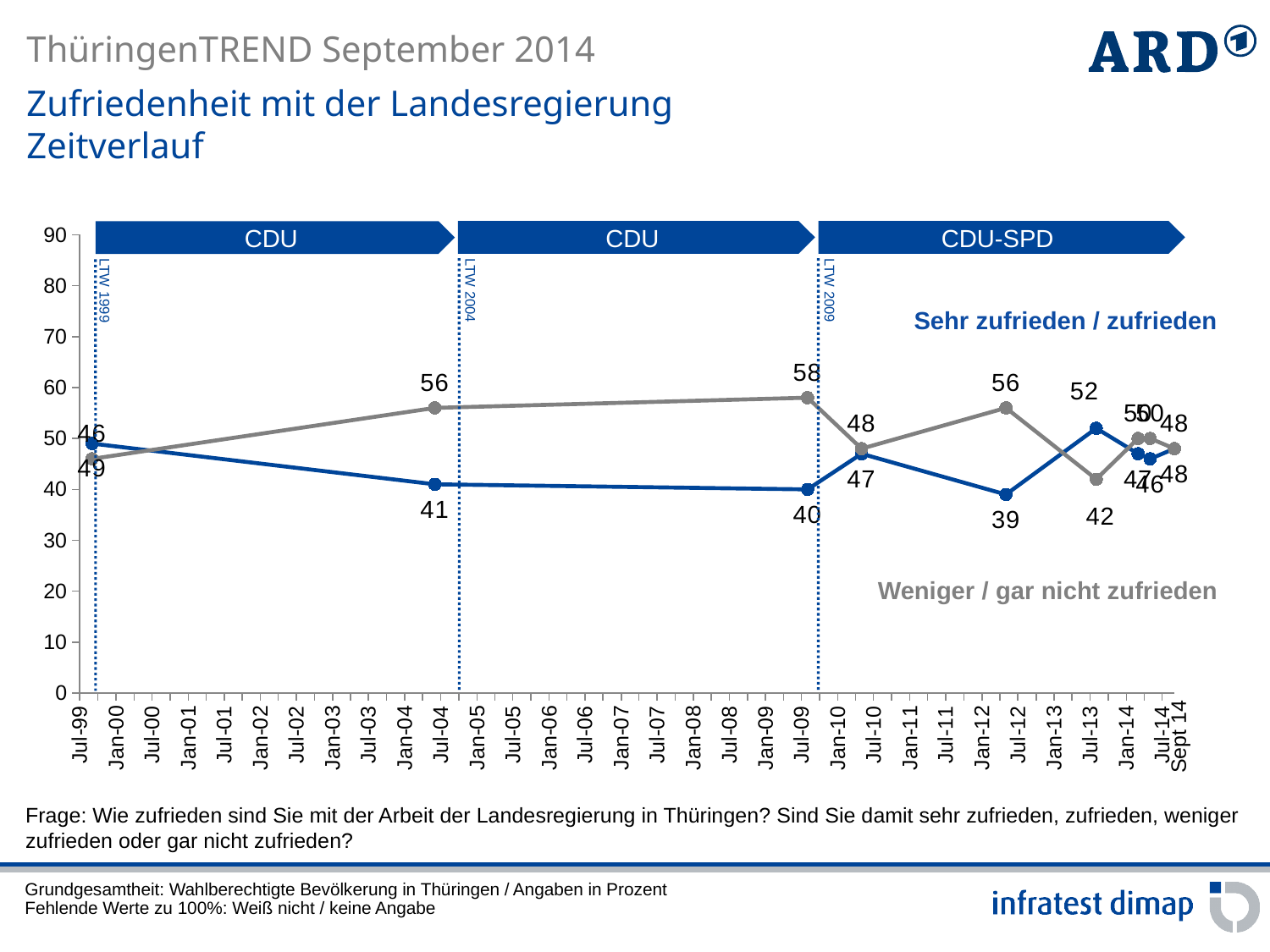
At which point does the "Weniger / gar nicht zufrieden" series reach its highest value? Jul-09 What is the value for "Sehr zufrieden / zufrieden" at Jul-13? 52 At Jul-13, which series has the larger value, "Sehr zufrieden / zufrieden" or "Weniger / gar nicht zufrieden"? Sehr zufrieden / zufrieden At which point does the "Sehr zufrieden / zufrieden" series reach its lowest value? Jul-12 What is the value for "Weniger / gar nicht zufrieden" at Jul-09? 58 What is the difference between "Weniger / gar nicht zufrieden" and "Sehr zufrieden / zufrieden" at Jul-09? 18 How many series are plotted in the chart? 2 Is the value for "Weniger / gar nicht zufrieden" at Jul-04 greater or less than 50? greater What is the value for "Weniger / gar nicht zufrieden" at Jul-12? 56 What is the value for "Sehr zufrieden / zufrieden" at Jul-04? 41 What kind of chart is shown on the slide? line chart Which coalition is labelled in the band above the chart for the period after LTW 2009? CDU-SPD